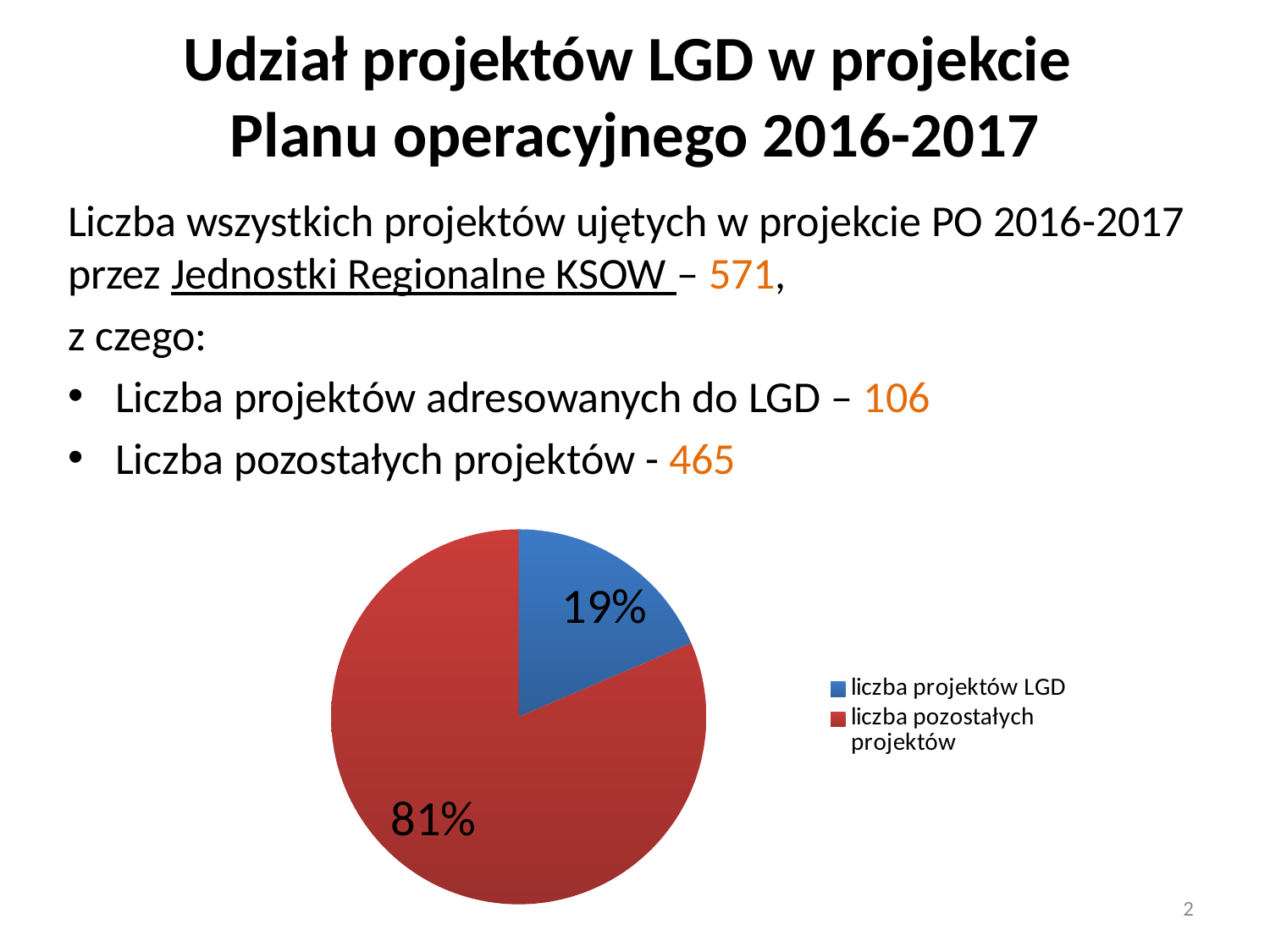
How many entries does the legend list? 2 Which slice of the pie is the largest? liczba pozostałych projektów What kind of chart is shown on the slide? pie chart Which slice of the pie is the smallest? liczba projektów LGD What colour is the "liczba pozostałych projektów" slice? red What share of the pie does "liczba pozostałych projektów" represent? 81% What colour is the "liczba projektów LGD" slice? blue How many slices does the pie chart have? 2 Which is larger: the share for "liczba projektów LGD" or the share for "liczba pozostałych projektów"? liczba pozostałych projektów What share of the pie does "liczba projektów LGD" represent? 19% What is the difference in percentage points between the "liczba pozostałych projektów" slice and the "liczba projektów LGD" slice? 62 percentage points